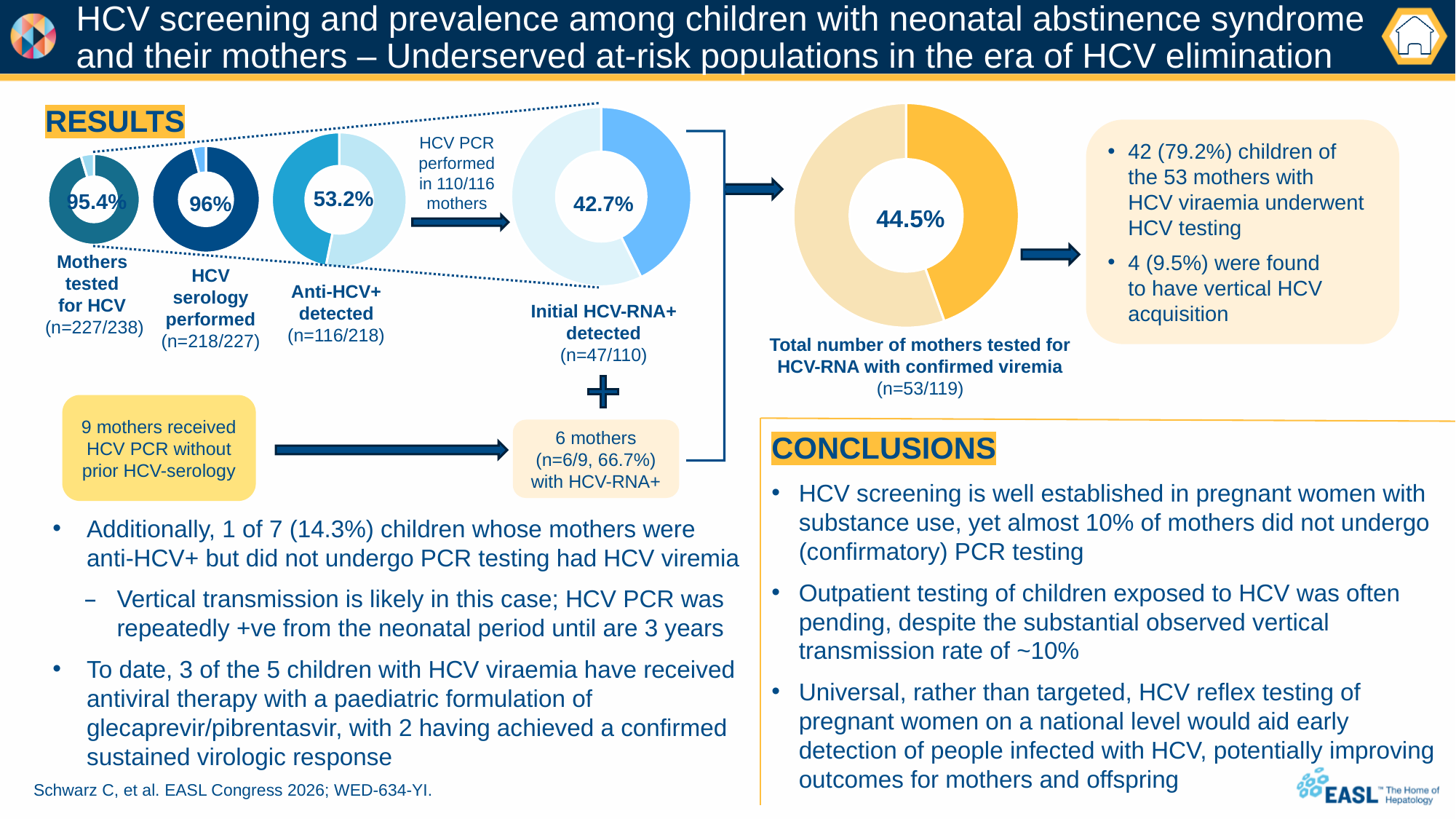
Which is larger: the percentage in the 'Anti-HCV+ detected' chart or the 'Initial HCV-RNA+ detected' chart? Anti-HCV+ detected What percentage is shown in the 'Initial HCV-RNA+ detected' donut chart? 42.7% What is the difference between the percentages in the 'Anti-HCV+ detected' chart and the 'Initial HCV-RNA+ detected' chart? 10.5% How many donut charts are shown on the slide? 5 What percentage is shown in the 'Mothers tested for HCV' donut chart? 95.4% What percentage is shown in the 'Anti-HCV+ detected' donut chart? 53.2% What percentage is shown in the large donut chart labelled 'Total number of mothers tested for HCV-RNA with confirmed viremia'? 44.5% What kind of charts are used in the RESULTS section of the slide? Donut (pie) charts Which donut chart shows the highest percentage? HCV serology performed (96%) What sample size (n) is given beneath the 'Initial HCV-RNA+ detected' donut chart? n=47/110 What percentage is shown in the 'HCV serology performed' donut chart? 96% Which donut chart shows the lowest percentage? Initial HCV-RNA+ detected (42.7%)